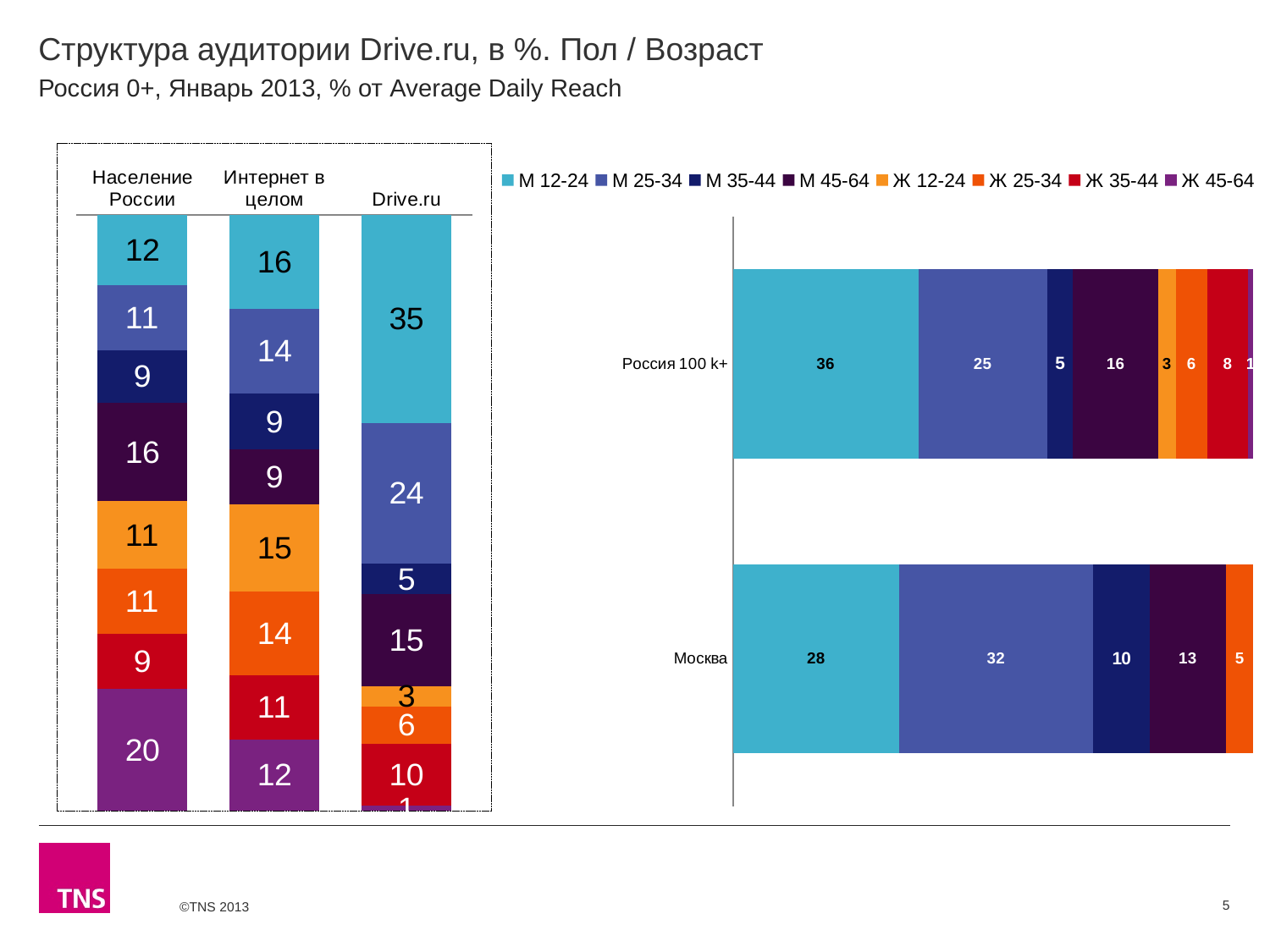
In the left chart, what is the value of the М 45-64 segment of the Интернет в целом bar? 9 In the right chart, which segment is the largest for Москва? М 25-34 In the right chart, what is the difference between the М 12-24 values for Россия 100 k+ and Москва? 8 In the left chart, what is the value of the bottom (Ж 45-64) segment of the Население России bar? 20 How many series does the legend on the right chart list? 8 In the right chart, which segment is the largest for Россия 100 k+? М 12-24 How many categories (bars) does the right chart show? 2 In the right chart, what is the value of the М 12-24 segment for Россия 100 k+? 36 In the right chart, what is the value of the М 25-34 segment for Москва? 32 What kind of chart is the chart on the right? Stacked bar chart In the left chart, what is the value of the top (М 12-24) segment of the Drive.ru bar? 35 In the left chart, which bar has the larger М 25-34 segment, Интернет в целом or Drive.ru? Drive.ru